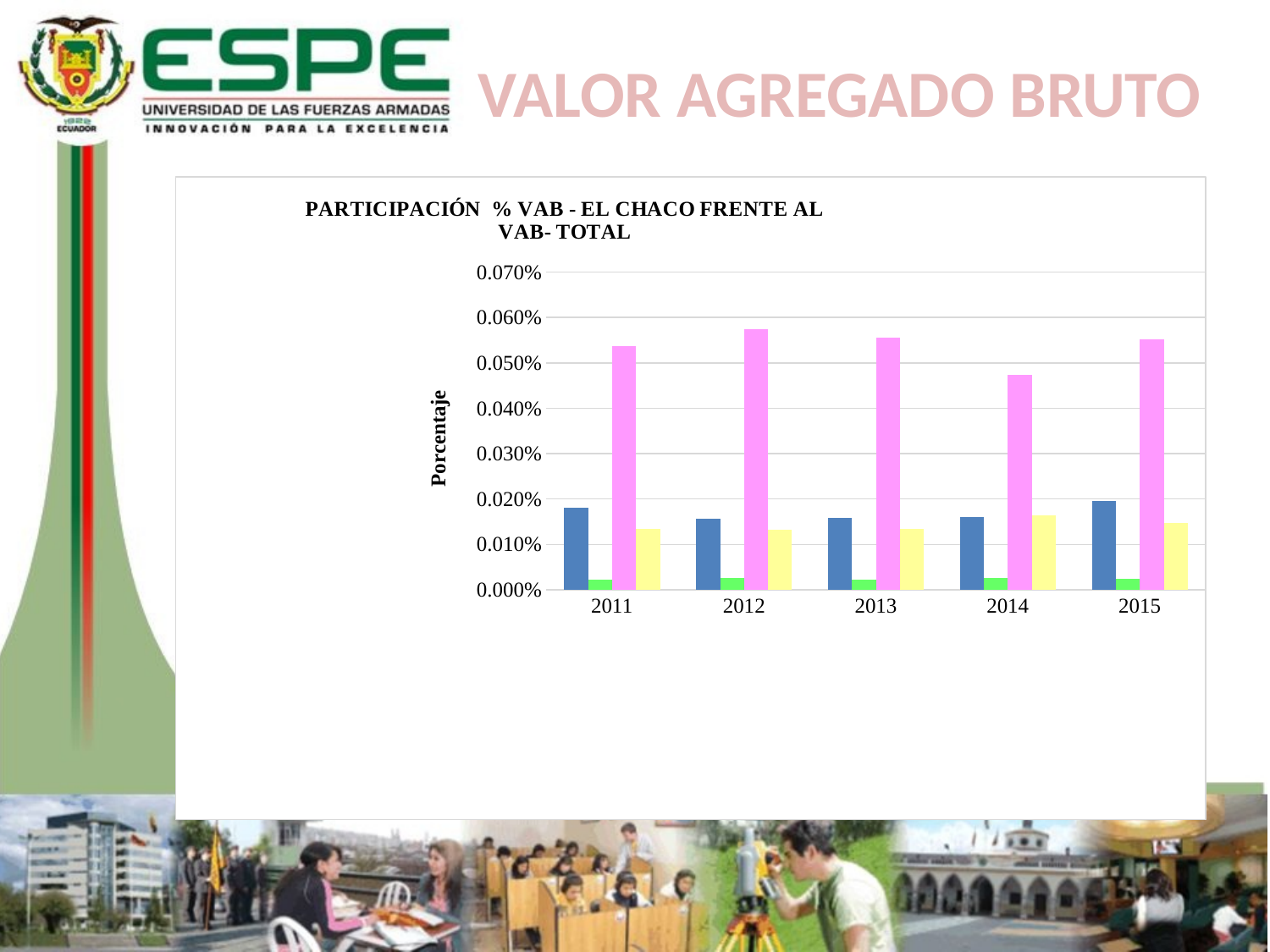
How many bars are plotted for each year in the chart? 4 What kind of chart is shown on the slide? bar chart Is the value of the blue bar for 2011 greater or less than 0.020%? less Which colour of bar is the shortest in every year of the chart? green In which year is the pink bar the lowest? 2014 Which colour of bar is the tallest in every year of the chart? pink Is the value of the pink bar for 2014 greater or less than 0.050%? less In which year is the pink bar the highest? 2012 How many years are shown on the x axis of the chart? 5 What is the title of the chart? PARTICIPACIÓN % VAB - EL CHACO FRENTE AL VAB- TOTAL What is the label of the vertical axis of the chart? Porcentaje Is the value of the pink bar for 2011 greater or less than 0.050%? greater